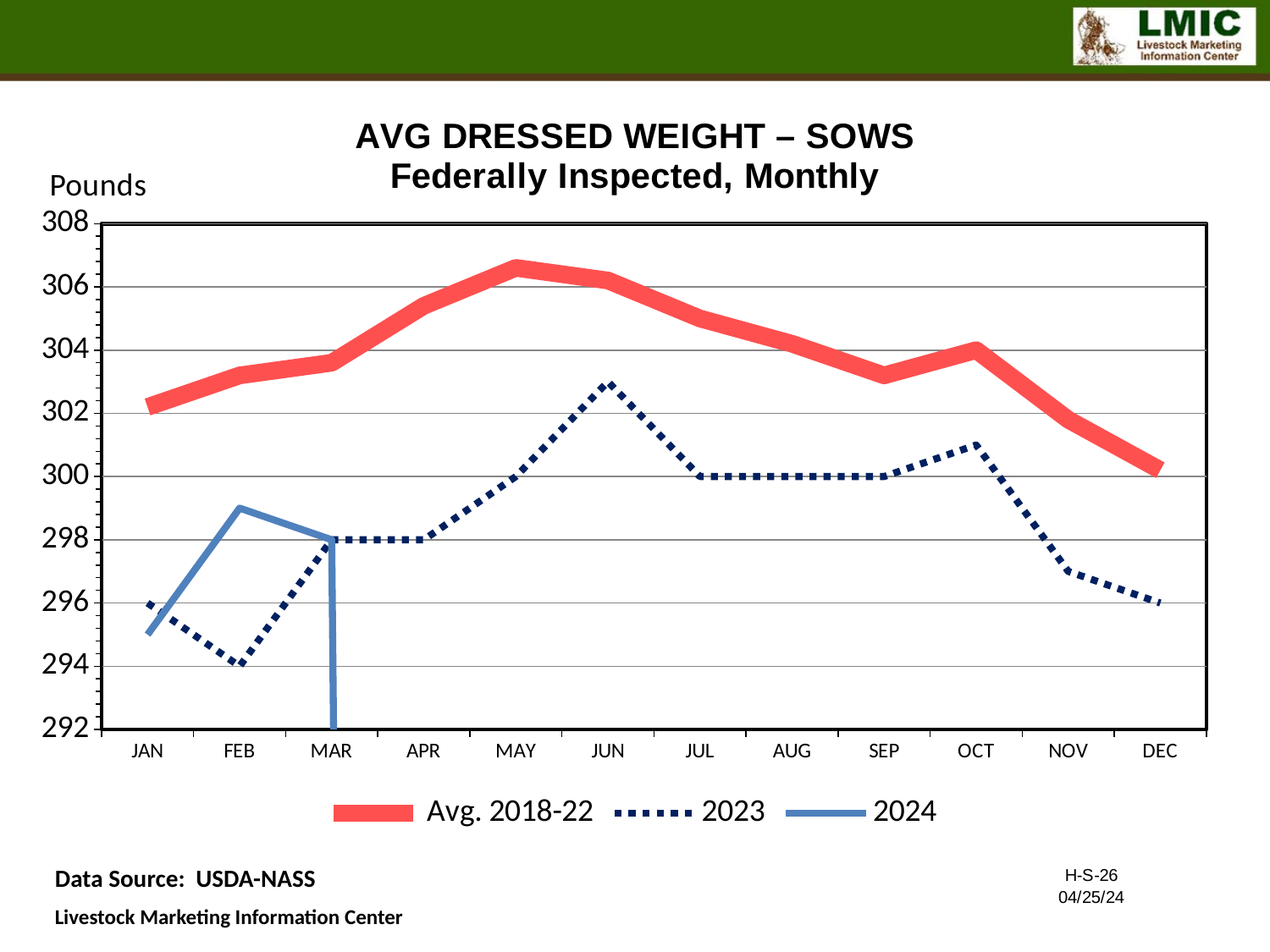
Which series has the higher value in FEB, 2023 or 2024? 2024 Is the 2024 value for JAN greater or less than 296? less In which month does the Avg. 2018-22 series reach its lowest value? DEC Does the Avg. 2018-22 series rise or fall from JAN to MAY? rise In which month does the 2023 series reach its lowest value? FEB In which month does the Avg. 2018-22 series reach its highest value? MAY How many months are shown along the x axis? 12 What kind of chart is shown on the slide? line chart Which series has the higher value in JUN, Avg. 2018-22 or 2023? Avg. 2018-22 How many series does the legend list? 3 Is the Avg. 2018-22 value for MAY greater or less than 306? greater In which month does the 2023 series reach its highest value? JUN